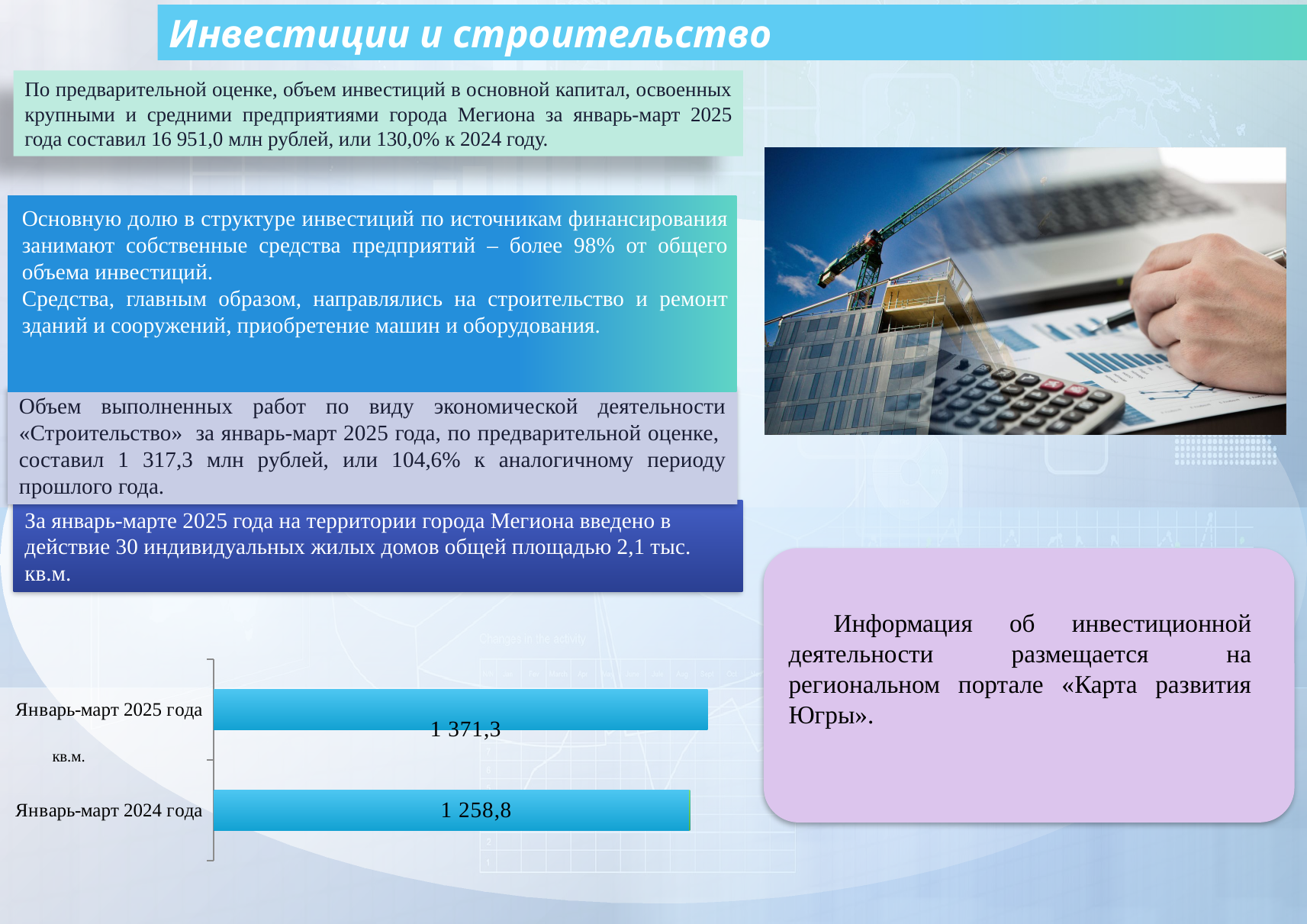
Which is larger on the bar chart: the value for Январь-март 2025 года or for Январь-март 2024 года? Январь-март 2025 года Are the bars on the chart oriented horizontally or vertically? Horizontally What is the value for Январь-март 2025 года on the bar chart? 1 371,3 Which category has the highest value on the bar chart? Январь-март 2025 года What kind of chart is shown at the bottom left of the slide? Bar chart What unit label is shown between the two bars on the chart? кв.м. How many categories are shown on the bar chart? 2 What is the difference between the values for Январь-март 2025 года and Январь-март 2024 года on the bar chart? 112,5 Which category has the lowest value on the bar chart? Январь-март 2024 года What is the value for Январь-март 2024 года on the bar chart? 1 258,8